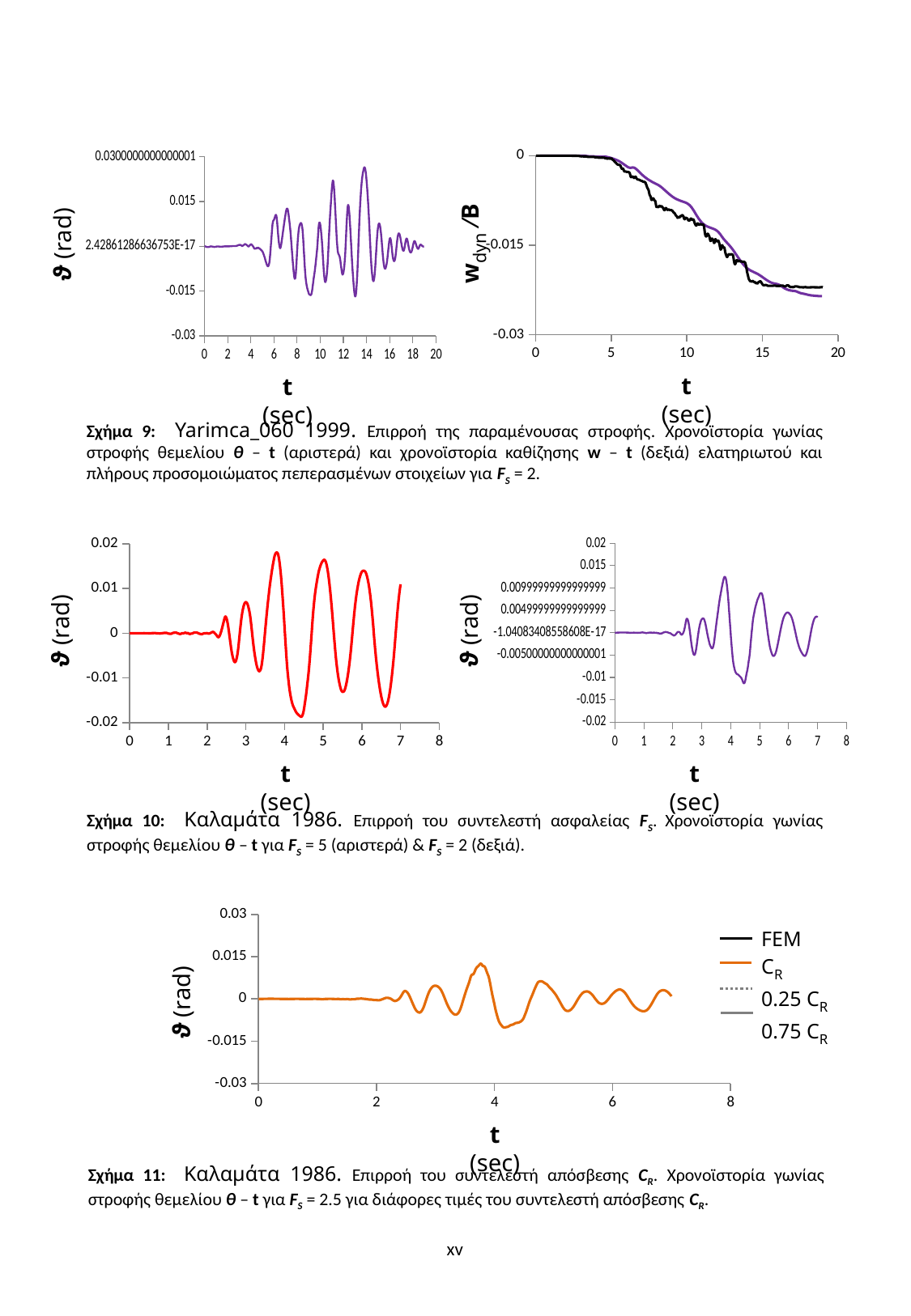
In the right chart of Figure 9, is the value of the purple line at t = 19 greater or less than -0.015? less How many lines are plotted in the right chart of Figure 9? 2 In the right chart of Figure 9, is the value of the black line at t = 5 greater or less than -0.015? greater What kind of chart is the bottom chart (Figure 11)? line chart What is the y-axis label of the left chart of Figure 10? ϑ (rad) In the bottom chart (Figure 11), which legend entry is drawn with a black line? FEM In the right chart of Figure 9 (w_dyn/B versus t), do the values rise or fall as t increases? fall In the left chart of Figure 10 (red line), is the peak value near t = 3.8 greater or less than 0.01? greater What kind of chart is the left chart of Figure 9? line chart In the bottom chart (Figure 11, Καλαμάτα 1986), how many series does the legend list? 4